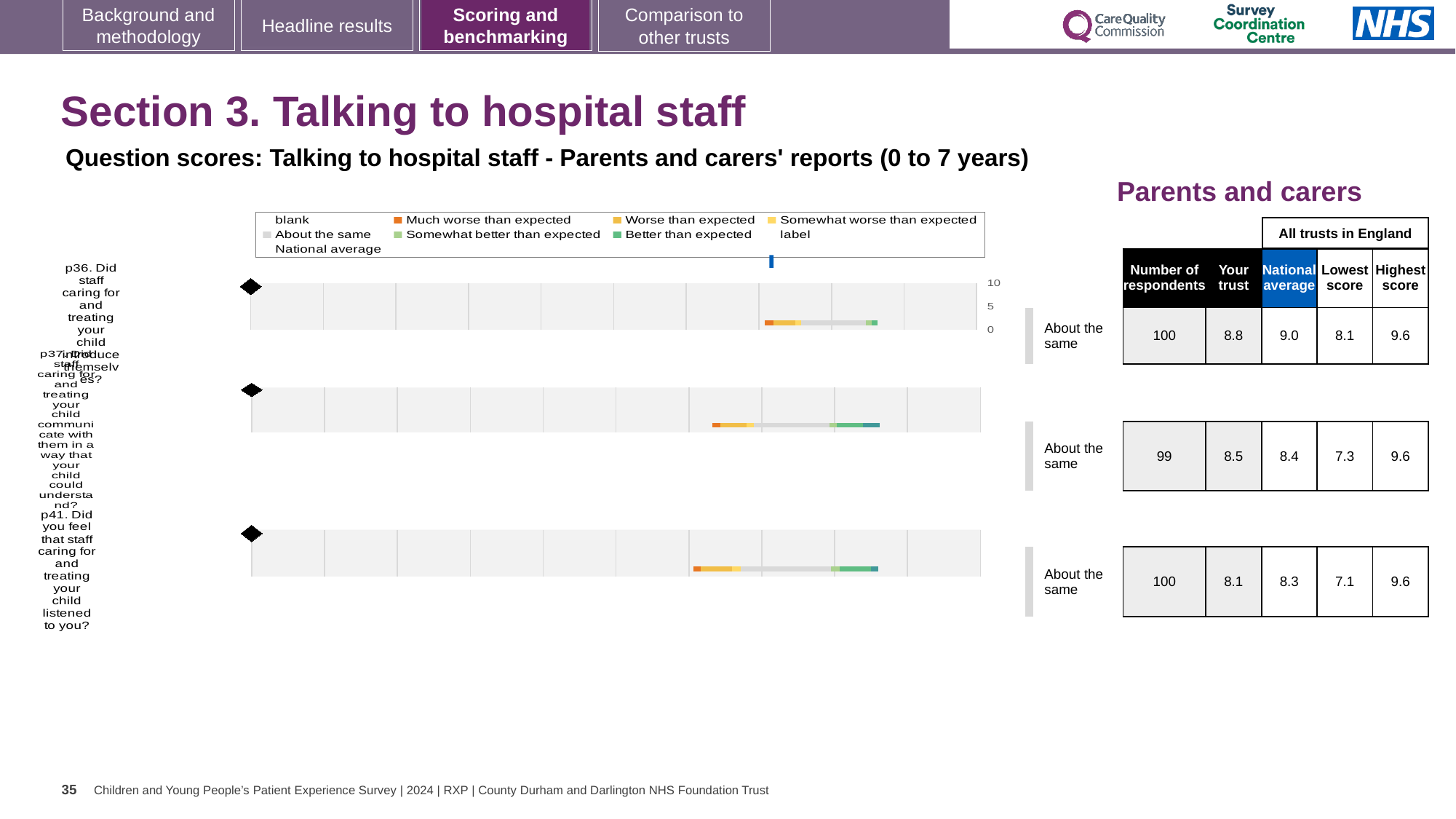
What colour does the legend use for 'Better than expected'? green In the table beside the chart, what is the 'Number of respondents' for the third row (p41)? 100 What colour does the legend use for 'Much worse than expected'? orange In the table beside the chart, what is the 'Your trust' score for the first row (p36)? 8.8 What kind of chart is shown on the slide? bar chart How many entries does the chart legend list? 9 In the table beside the chart, which row has the highest 'Your trust' score? p36 What benchmark label is shown next to each of the three bars? About the same In the table beside the chart, for the first row (p36), which is larger: 'Your trust' or 'National average'? National average How many question categories (bars) are plotted in the chart? 3 In the table beside the chart, what is the difference between the 'Highest score' and 'Lowest score' for the first row (p36)? 1.5 In the table beside the chart, what is the 'National average' for the second row (p37)? 8.4